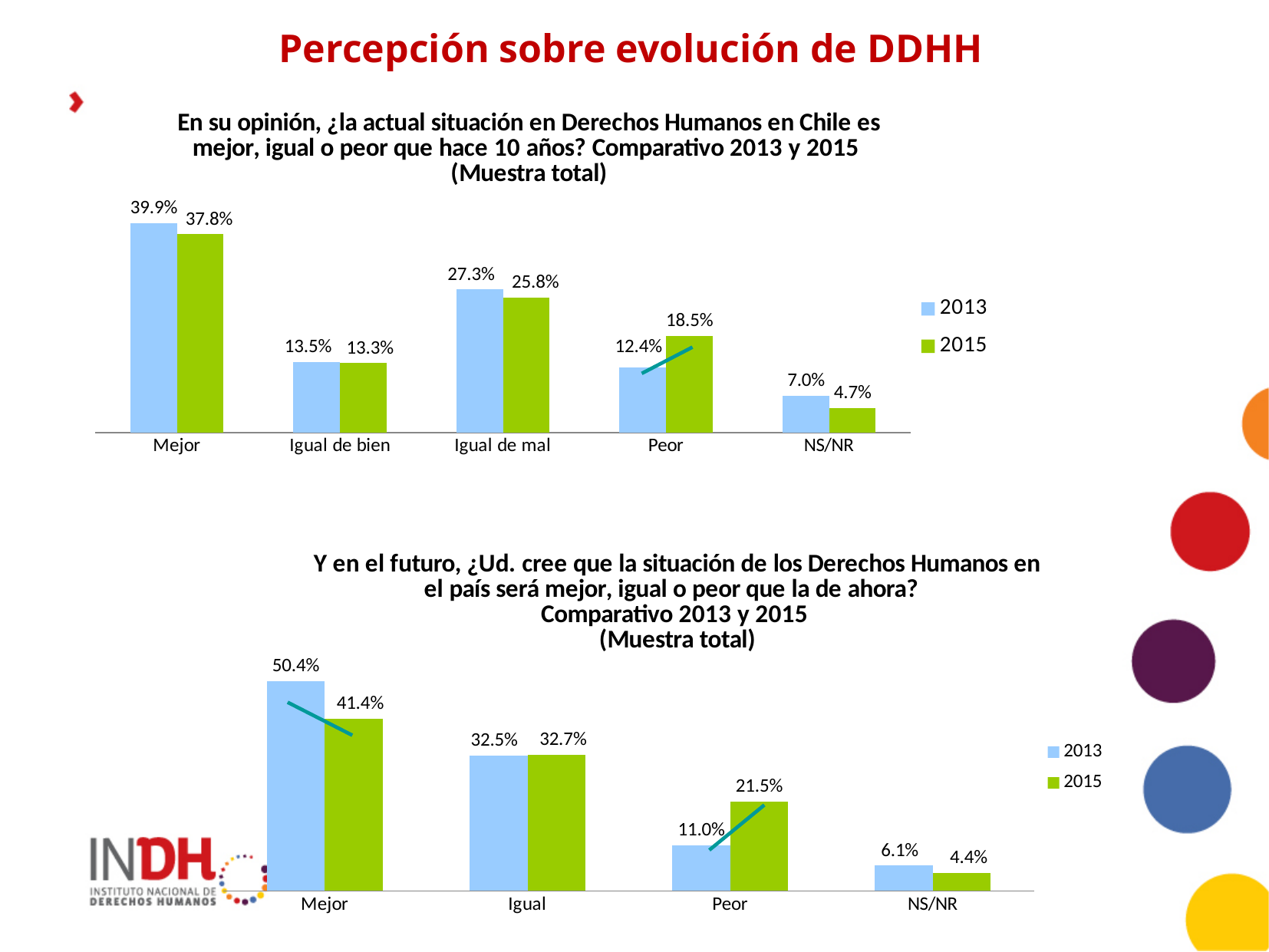
What type of chart is the bottom chart (future situation)? Bar chart In the top chart (current situation vs 10 years ago), how many categories are shown on the x axis? 5 In the top chart (current situation vs 10 years ago), which is larger for Igual de mal: the 2013 value or the 2015 value? 2013 In the bottom chart (future situation), what is the 2013 value for Mejor? 50.4% In the top chart (current situation vs 10 years ago), which category has the lowest 2015 value? NS/NR In the bottom chart (future situation), what is the 2015 value for NS/NR? 4.4% In the top chart (current situation vs 10 years ago), what is the 2013 value for Mejor? 39.9% In the top chart (current situation vs 10 years ago), what is the 2015 value for Peor? 18.5% In the bottom chart (future situation), which category has the highest 2015 value? Mejor In the top chart (current situation vs 10 years ago), what is the difference between the 2015 and 2013 values for Peor? 6.1 percentage points In the bottom chart (future situation), what is the difference between the 2013 and 2015 values for Mejor? 9.0 percentage points In the bottom chart (future situation), how many series does the legend list? 2